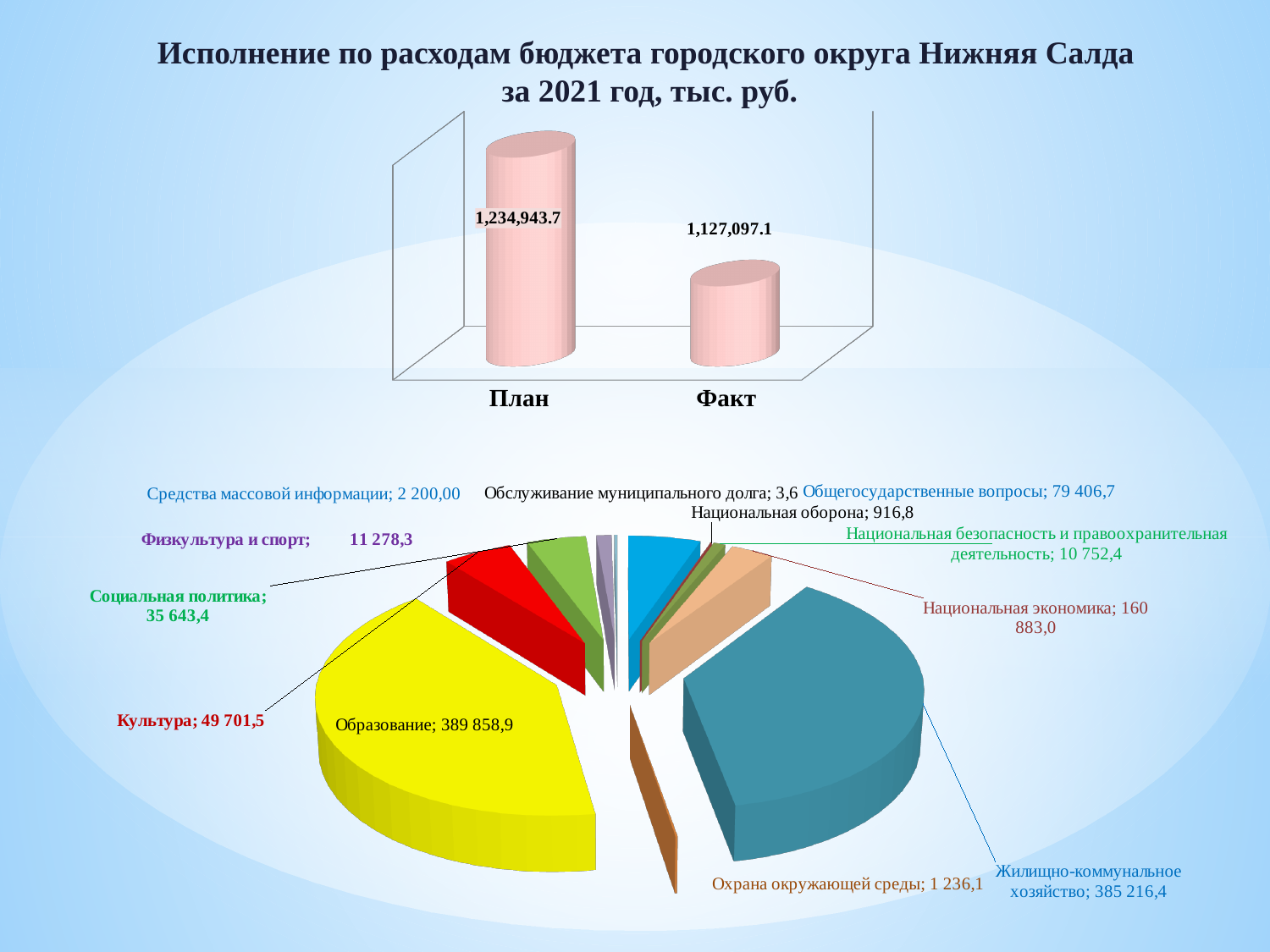
In the bottom pie chart, how many categories are shown? 12 In the top bar chart, what is the value for План? 1,234,943.7 In the bottom pie chart, what is the difference between Культура and Социальная политика? 14 058,1 In the top bar chart, what is the difference between План and Факт? 107,846.6 In the bottom pie chart, what is the value for Образование? 389 858,9 In the bottom pie chart, which category has the largest value? Образование In the top bar chart, which is larger, План or Факт? План What kind of chart is the top chart on the slide? Bar chart In the top bar chart, what is the value for Факт? 1,127,097.1 In the bottom pie chart, what is the value for Жилищно-коммунальное хозяйство? 385 216,4 In the bottom pie chart, which category has the smallest value? Обслуживание муниципального долга What kind of chart is the bottom chart on the slide? Pie chart